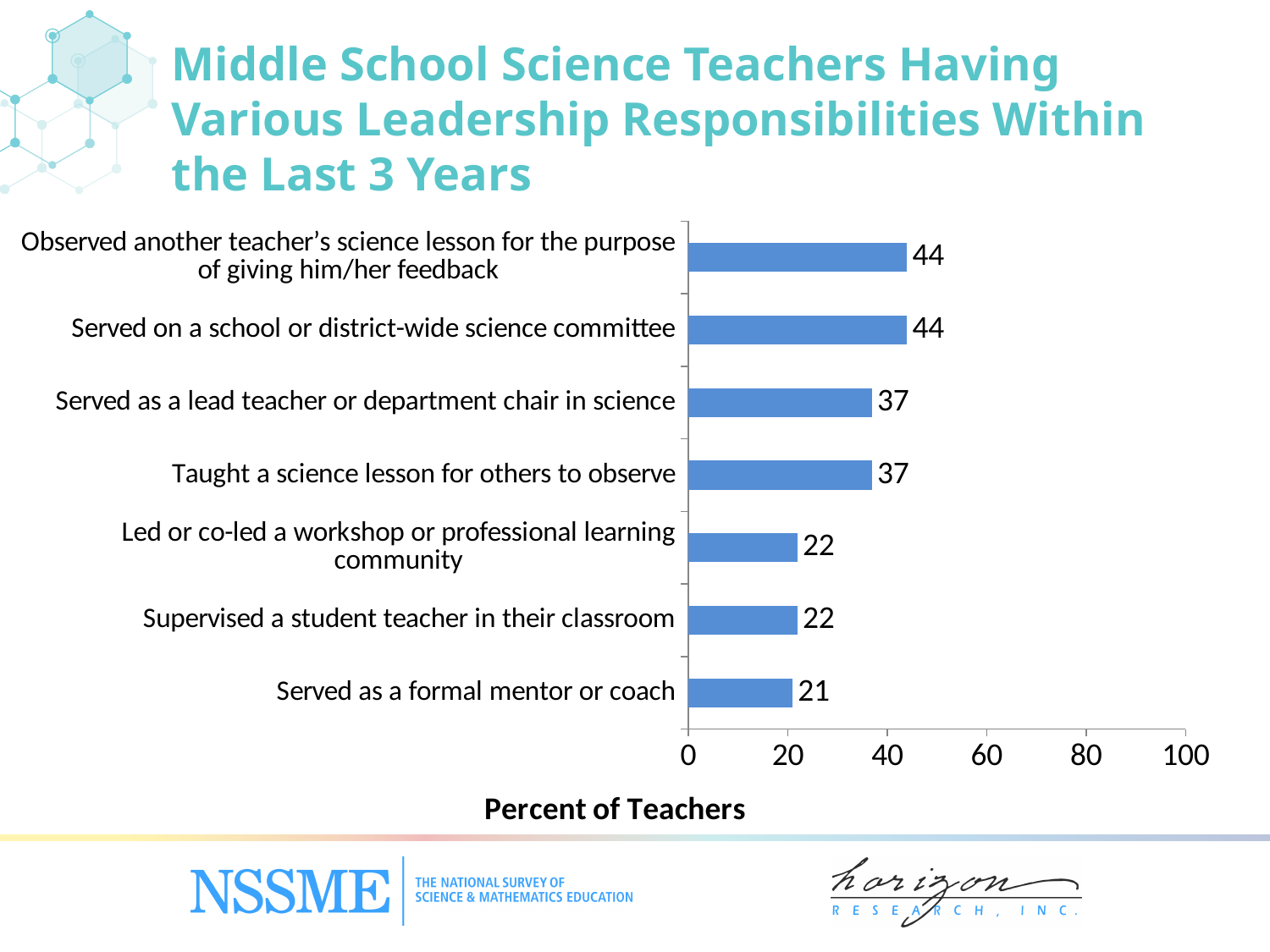
Is the value for 'Served on a school or district-wide science committee' greater or less than 40? greater What percent of teachers served as a formal mentor or coach? 21 Is the value for 'Supervised a student teacher in their classroom' greater or less than 40? less What kind of chart is shown on the slide? Bar chart Which leadership responsibility has the lowest percent of teachers? Served as a formal mentor or coach What is the difference in percent of teachers between teaching a science lesson for others to observe and serving as a formal mentor or coach? 16 What is the label of the horizontal axis? Percent of Teachers Which is larger: the percent of teachers who observed another teacher's science lesson for the purpose of giving feedback, or the percent who taught a science lesson for others to observe? Observed another teacher's science lesson for the purpose of giving him/her feedback How many leadership responsibilities are shown in the chart? 7 What percent of teachers led or co-led a workshop or professional learning community? 22 What percent of teachers served as a lead teacher or department chair in science? 37 What is the difference in percent of teachers between serving on a school or district-wide science committee and supervising a student teacher in their classroom? 22